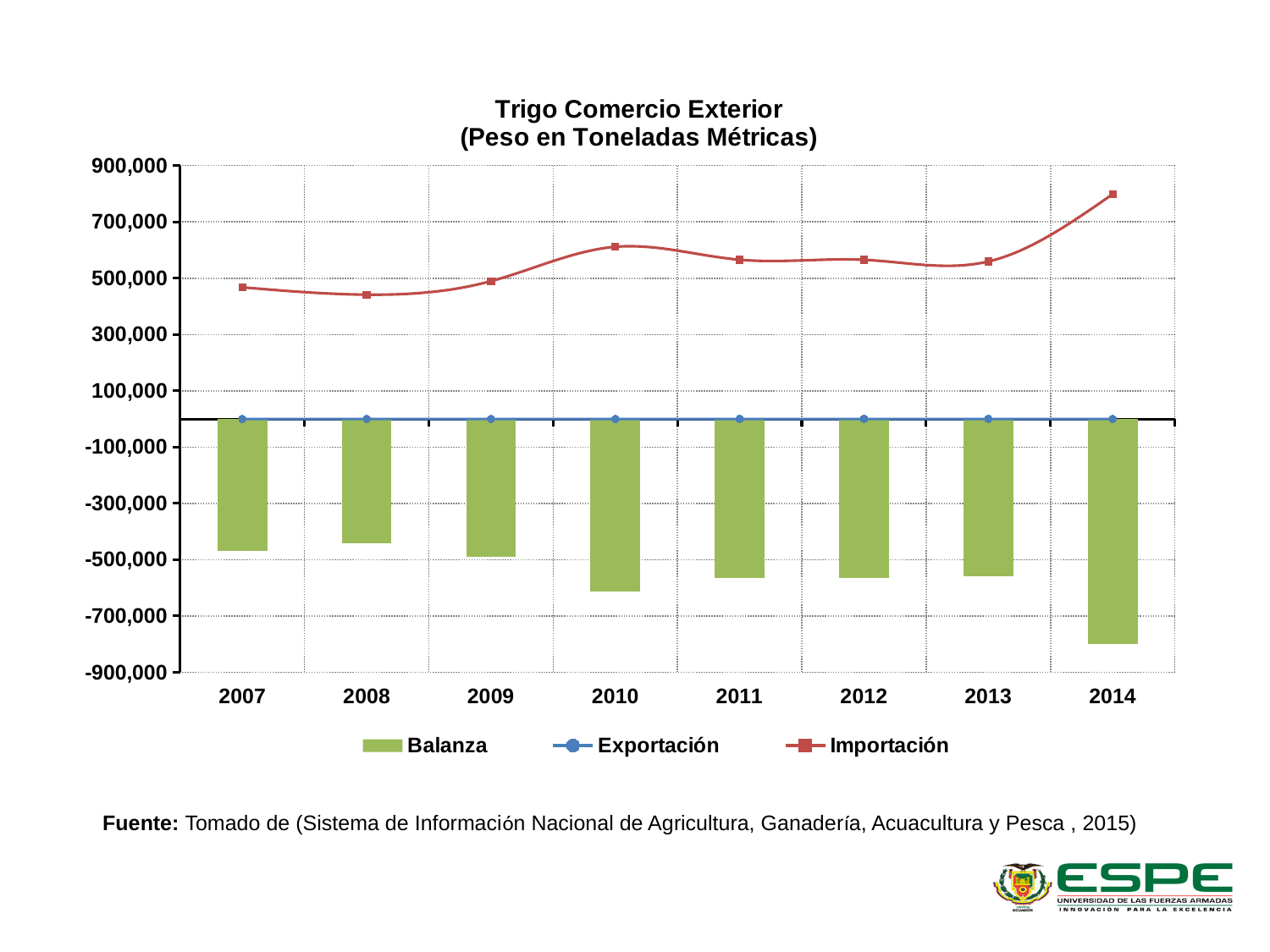
What kind of chart is shown on the slide? A combined bar and line chart How many years are shown on the x axis? 8 In which year is the Balanza bar lowest (most negative)? 2014 Is the Importación value for 2007 greater or less than 500,000? less In which year is Importación highest? 2014 Is the Balanza value for 2010 greater or less than -500,000? less Which series is drawn as green bars? Balanza How many series does the legend list? 3 Which year has the larger Importación value, 2010 or 2008? 2010 What is the title of the chart? Trigo Comercio Exterior (Peso en Toneladas Métricas) In which year is Importación lowest? 2008 Is the Importación value for 2014 greater or less than 700,000? greater